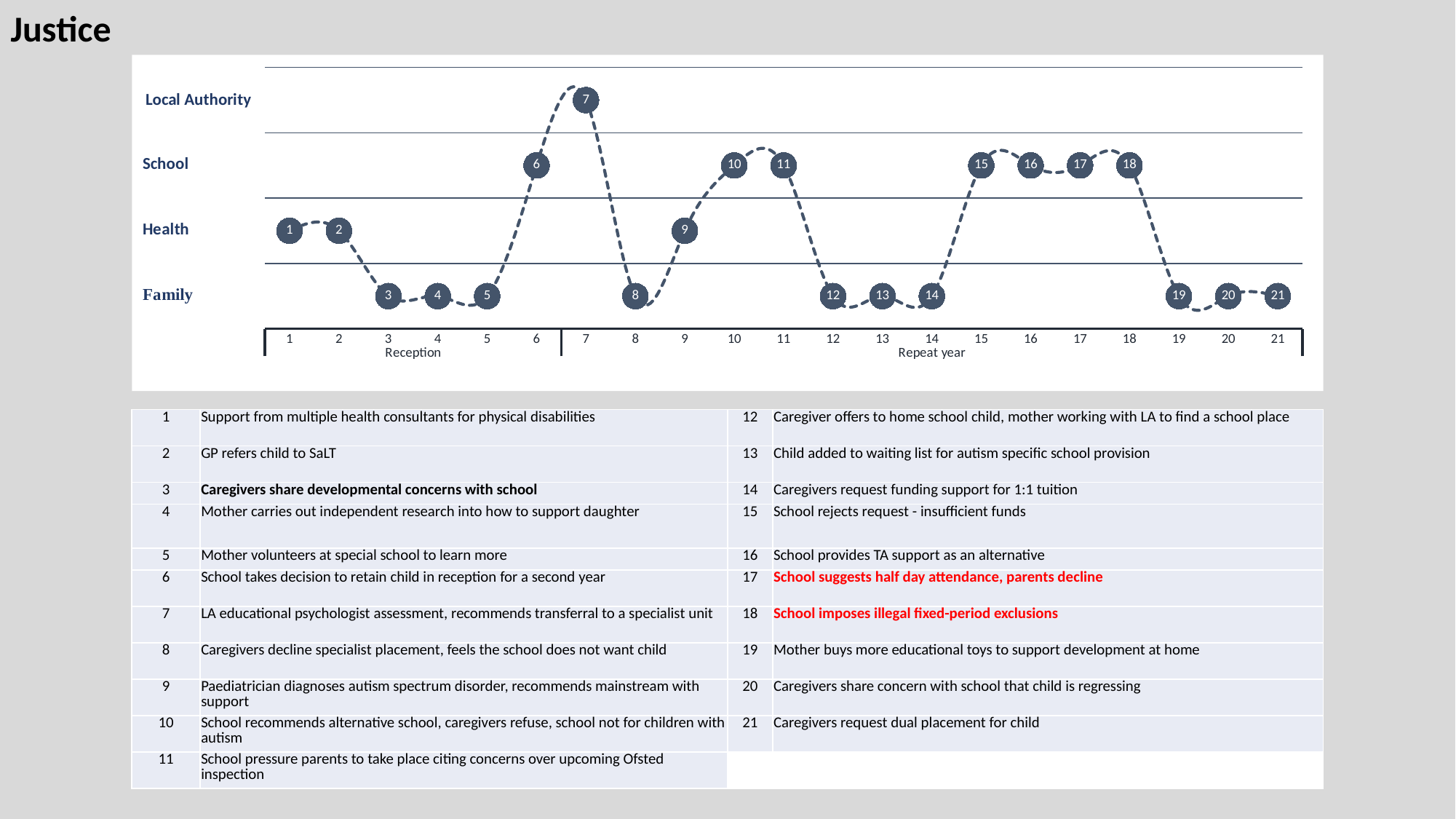
Which category on the vertical axis does point 16 land on? School How many category labels are listed on the vertical axis? 4 Which category on the vertical axis does point 9 land on? Health How many numbered points are plotted on the chart? 21 How many points land on the Local Authority row? 1 What kind of chart is shown on the slide? line chart Which phase label on the x axis covers points 1 to 6? Reception Which phase label on the x axis covers points 7 to 21? Repeat year Which category on the vertical axis does point 12 land on? Family Which category on the vertical axis does point 7 land on? Local Authority